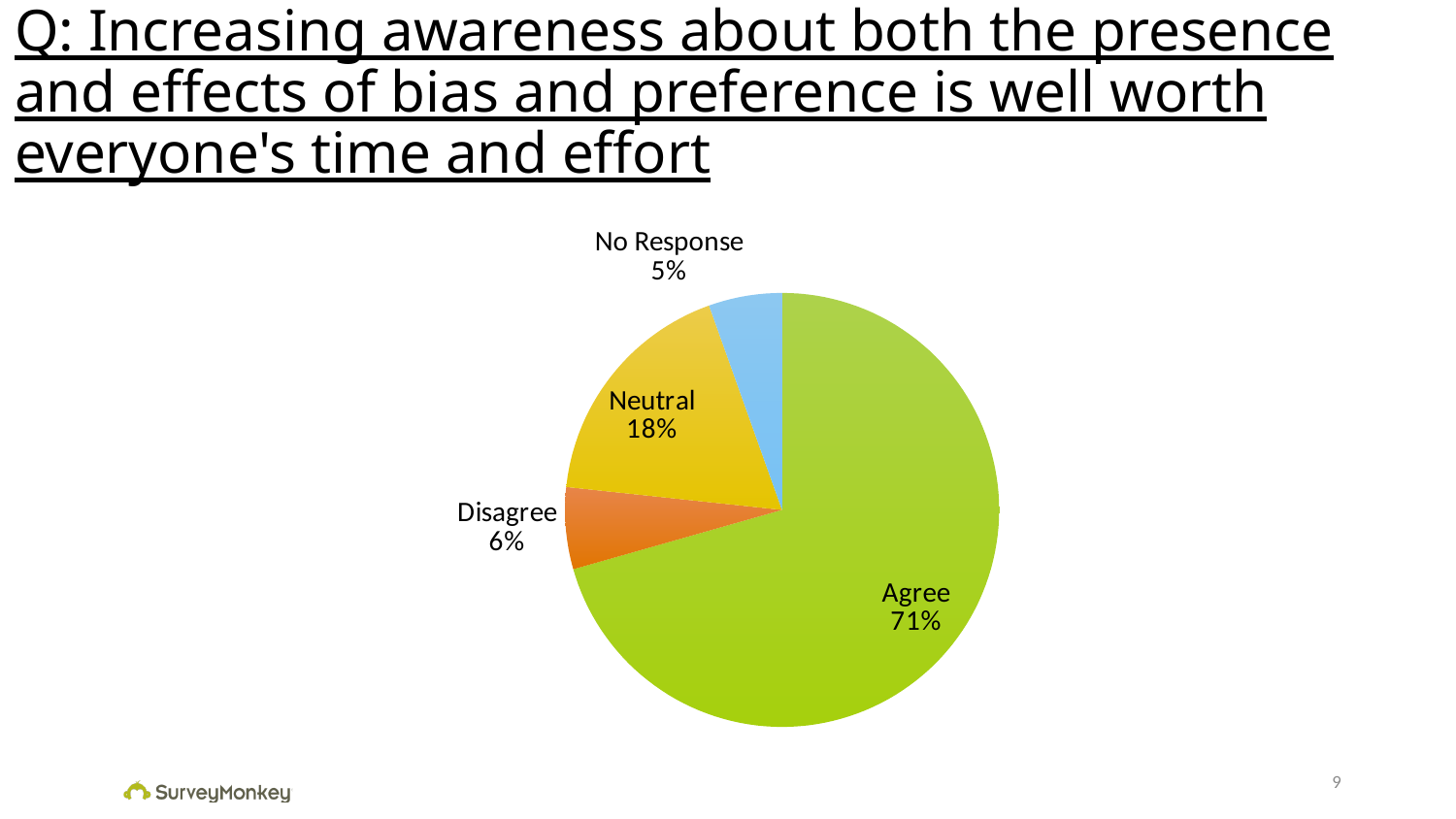
What is the combined percentage of Disagree and No Response? 11% Which is larger, the share for Neutral or the share for Disagree? Neutral Which response category has the largest share of the pie? Agree What is the difference in percentage points between Agree and Neutral? 53 Which response category has the smallest share of the pie? No Response What colour is the Agree slice of the pie? Green What percentage of respondents chose Agree? 71% What kind of chart is shown on the slide? Pie chart What percentage is shown for No Response? 5% What percentage of respondents chose Neutral? 18% How many slices does the pie chart have? 4 What percentage of respondents chose Disagree? 6%